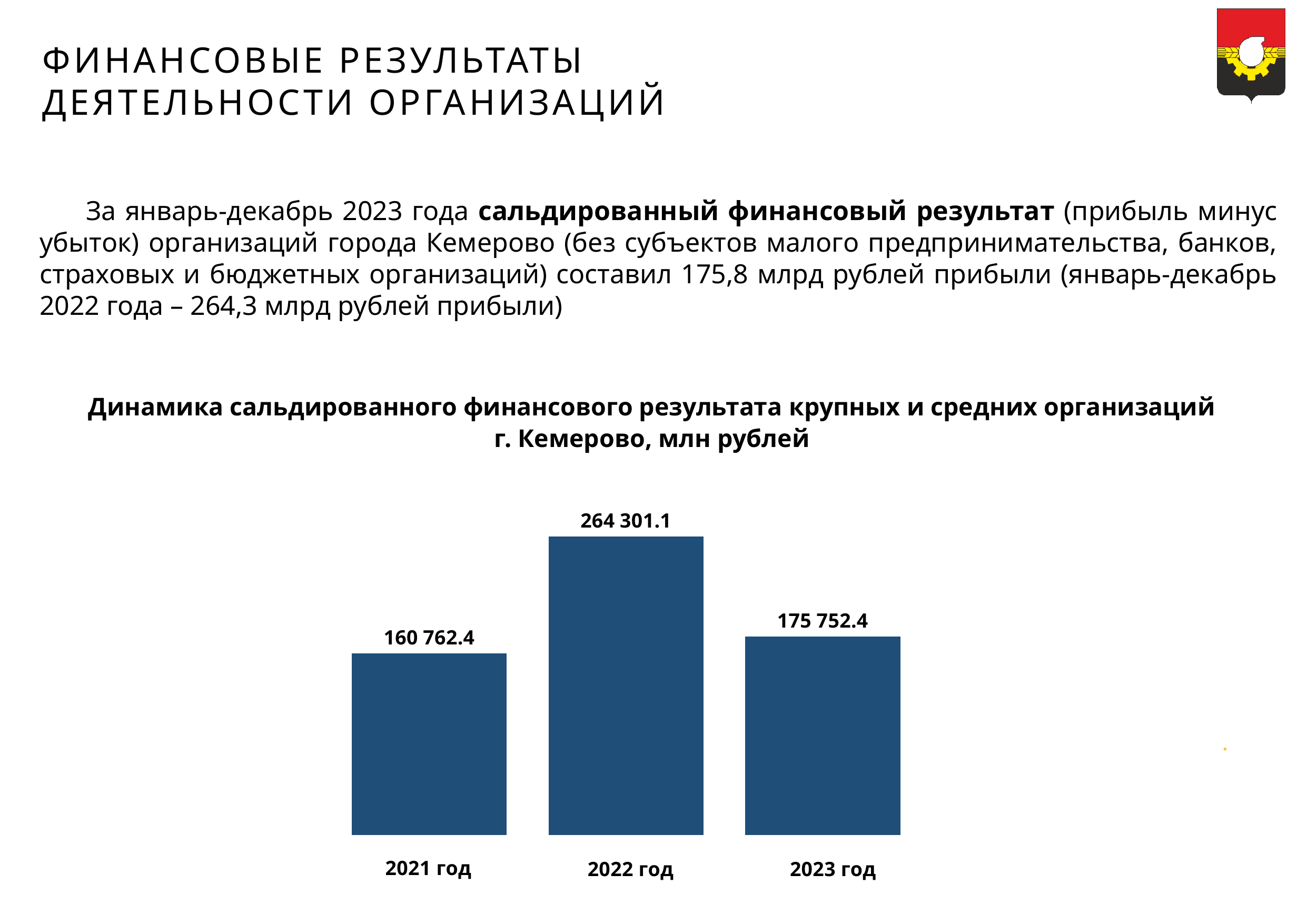
How many years are shown in the chart? 3 Which year has the lowest value? 2021 год Which year has the highest value? 2022 год What is the difference between the values for 2023 год and 2021 год? 14 990.0 What kind of chart is shown on the slide? bar chart What is the value for 2022 год? 264 301.1 What is the value for 2023 год? 175 752.4 What is the value for 2021 год? 160 762.4 What is the difference between the values for 2022 год and 2021 год? 103 538.7 Which is larger, the value for 2023 год or the value for 2021 год? 2023 год What is the difference between the values for 2022 год and 2023 год? 88 548.7 What unit of measurement is stated in the chart title? млн рублей